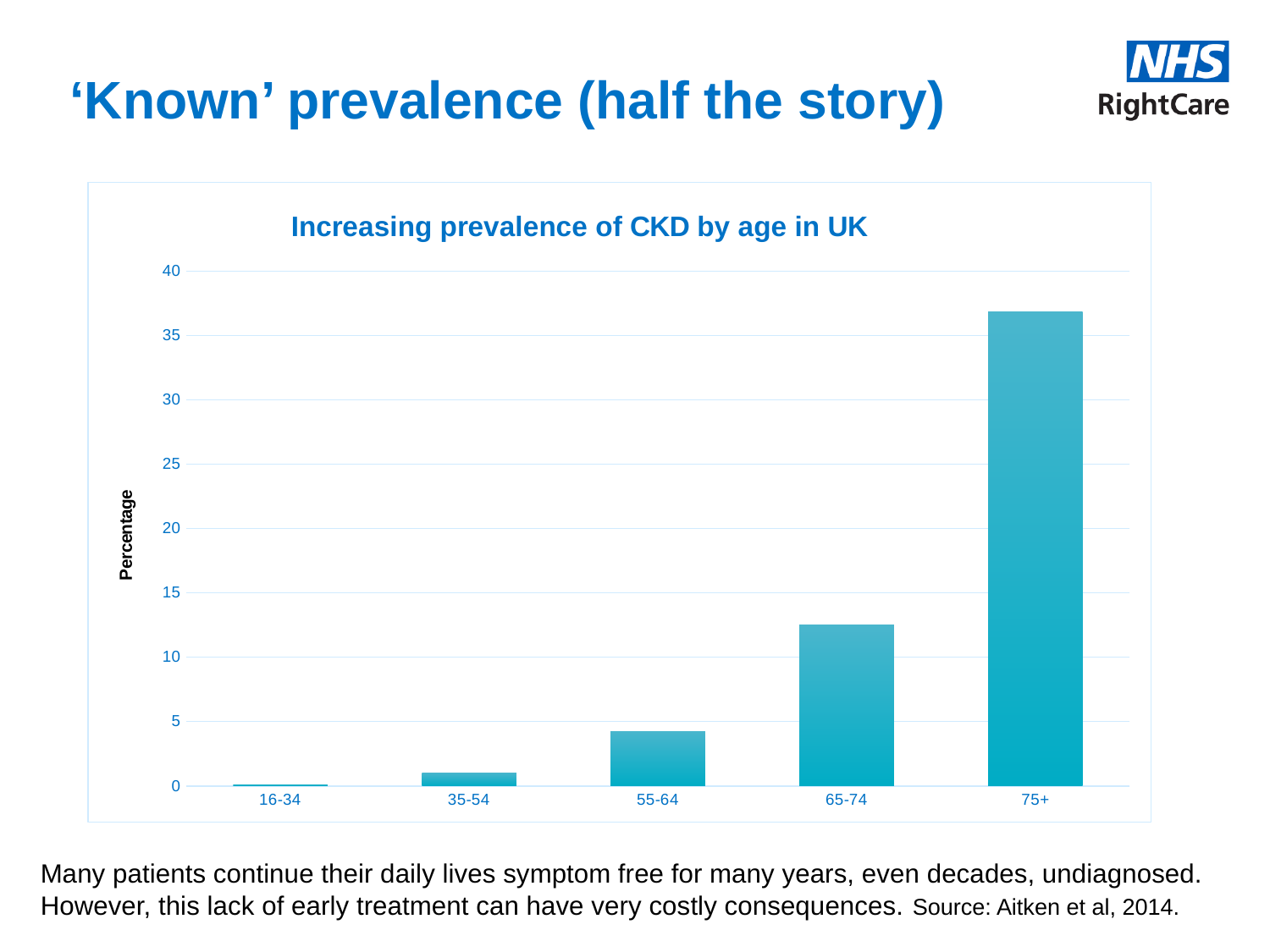
Is the value for 75+ greater or less than 35? greater Is the value for 55-64 greater or less than 5? less Do the values rise or fall as age increases along the x axis? rise What is the label on the y axis of the chart? Percentage What kind of chart is shown on the slide? bar chart What is the title of the chart? Increasing prevalence of CKD by age in UK Which age group has the lowest CKD prevalence in the chart? 16-34 How many age groups are shown on the x axis of the chart? 5 Which age group has a higher prevalence, 55-64 or 65-74? 65-74 Which age group has a higher prevalence, 35-54 or 75+? 75+ Is the value for 65-74 greater or less than 15? less Which age group has the highest CKD prevalence in the chart? 75+